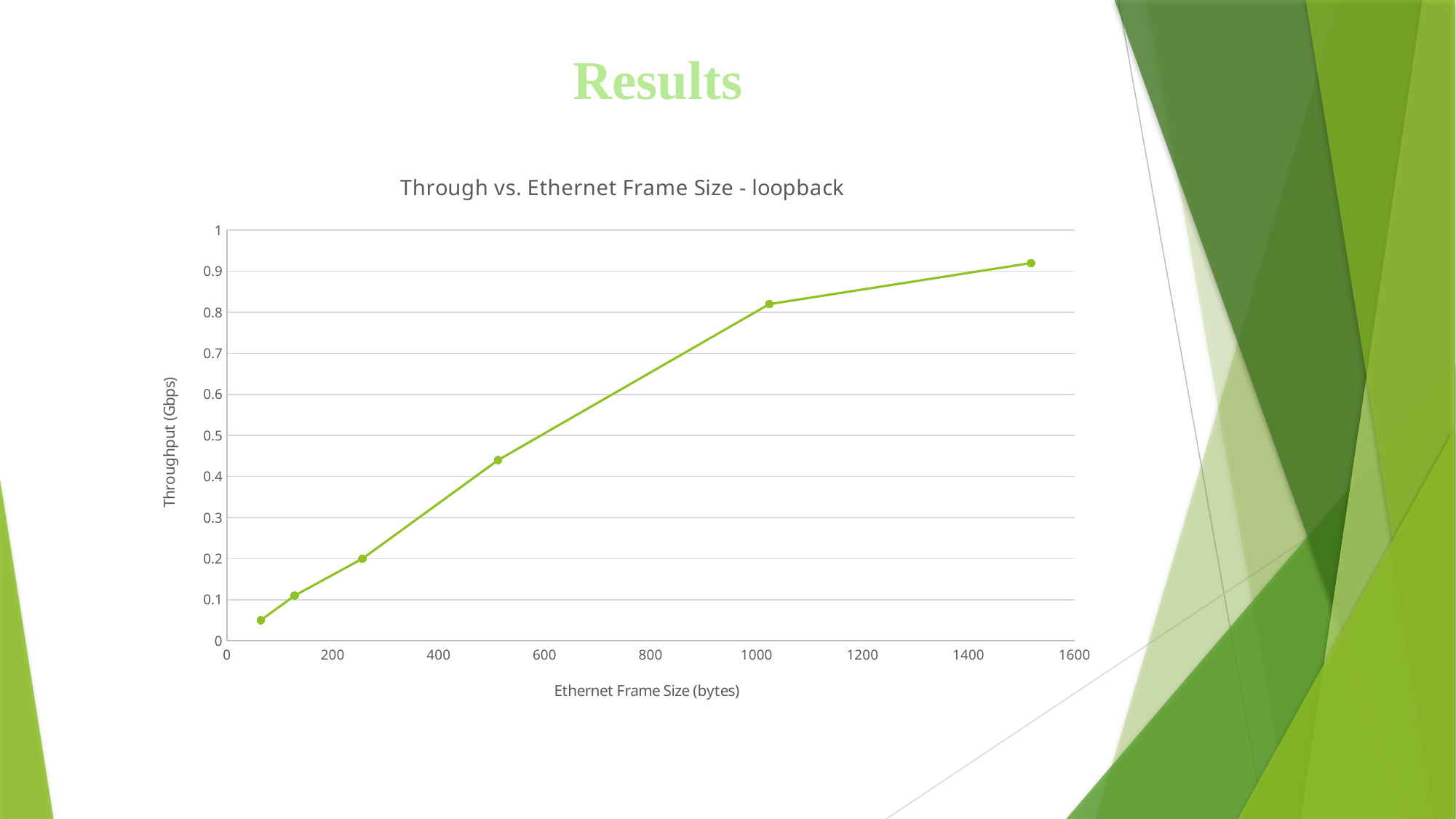
Is the throughput value for the leftmost point greater or less than 0.1? less Is the throughput value for the rightmost point (near 1500 bytes) greater or less than 0.9? greater Does throughput rise or fall as Ethernet frame size increases along the x axis? rise Which plotted point has the lowest throughput? the leftmost point (smallest frame size) Is the throughput value for the point nearest 1000 bytes greater or less than 0.8? greater How many data points are plotted on the line? 6 What is the title of the chart? Through vs. Ethernet Frame Size - loopback What kind of chart is shown on the slide? line chart What is the label of the vertical axis? Throughput (Gbps) Which point has the highest throughput: the leftmost point or the rightmost point? the rightmost point